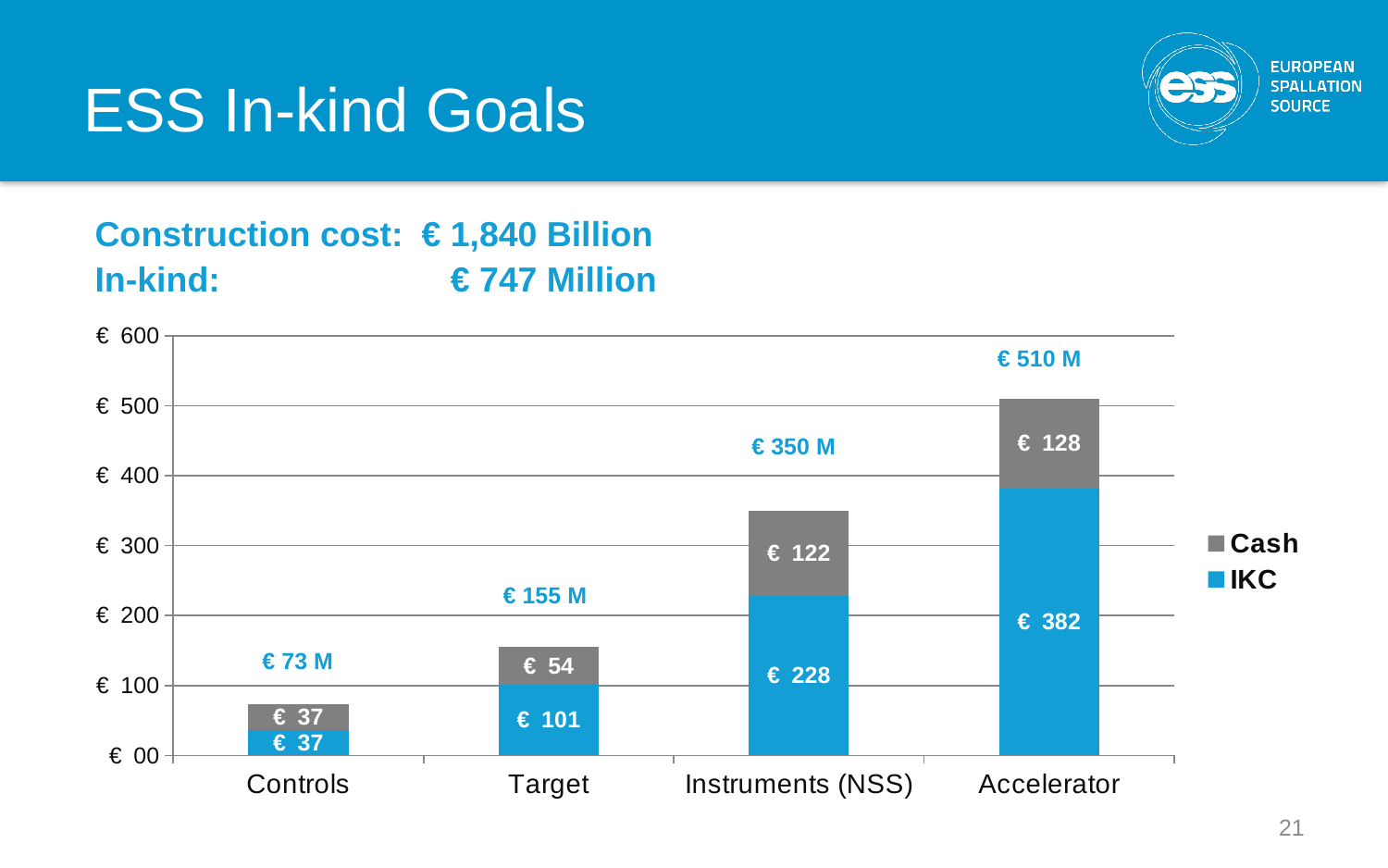
How many categories are shown on the x axis? 4 Which category has the highest total? Accelerator Which category has the lowest total? Controls What is the IKC value for Accelerator? € 382 What is the total shown above the Controls bar? € 73 M How many series does the legend list? 2 Which is larger, the IKC value for Instruments (NSS) or the Cash value for Accelerator? IKC value for Instruments (NSS) What is the Cash value for Instruments (NSS)? € 122 What is the IKC value for Target? € 101 What kind of chart is shown? Stacked bar chart What is the difference between the Cash values for Accelerator and Target? € 74 Do the bar totals rise or fall from Controls to Accelerator? Rise